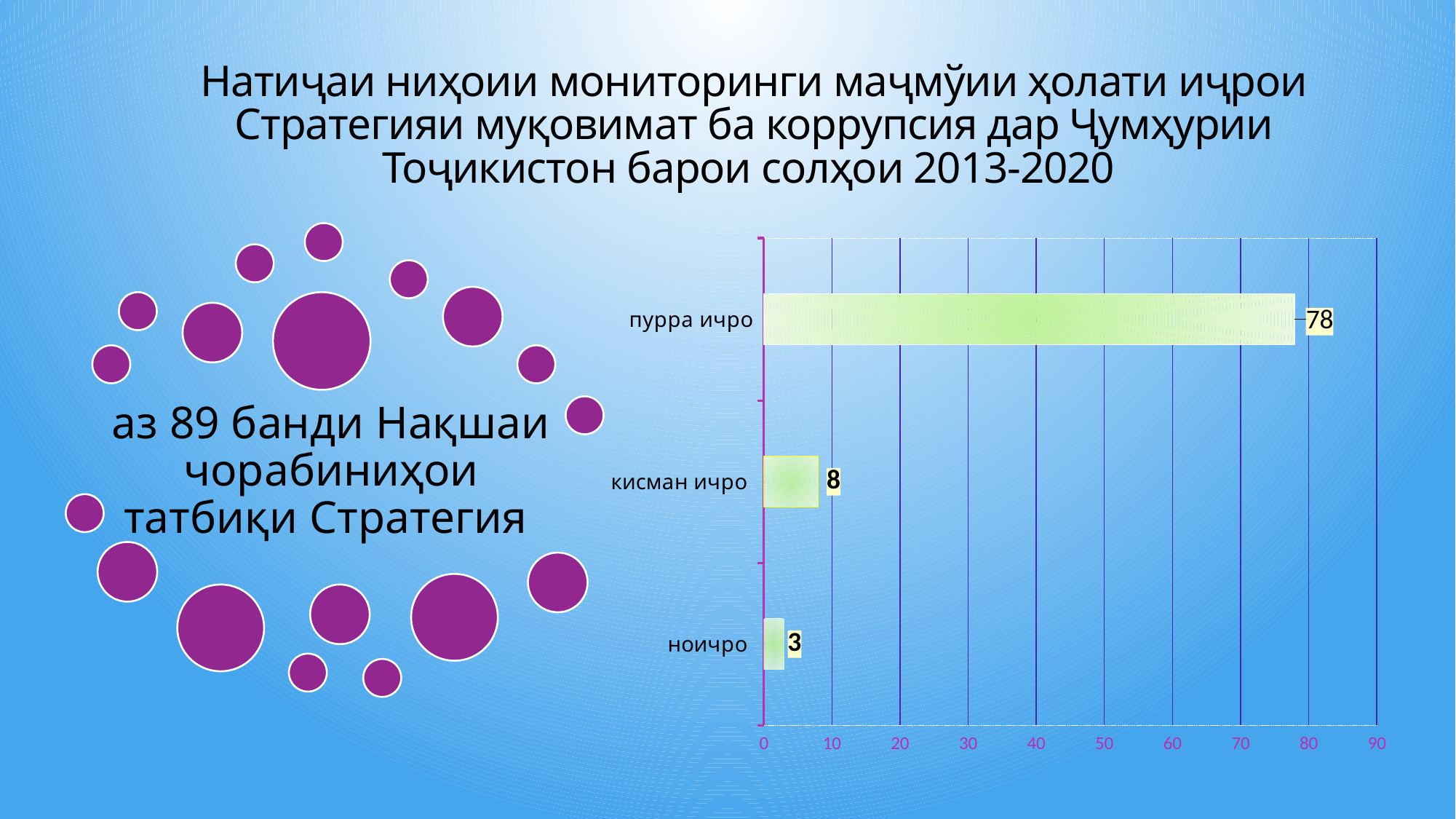
What is the value for "ноиҷро"? 3 What is the value for "пурра иҷро"? 78 What kind of chart is shown on the slide? bar chart Which category has the highest value? пурра ичро What is the value for "кисман иҷро"? 8 Which is larger, the value for "кисман иҷро" or the value for "ноиҷро"? кисман ичро What is the highest value shown on the horizontal axis of the chart? 90 Is the value for "пурра иҷро" greater or less than 70? greater What is the difference between the values for "пурра иҷро" and "кисман иҷро"? 70 How many categories are shown in the chart? 3 What is the difference between the values for "кисман иҷро" and "ноиҷро"? 5 Which category has the lowest value? ноичро